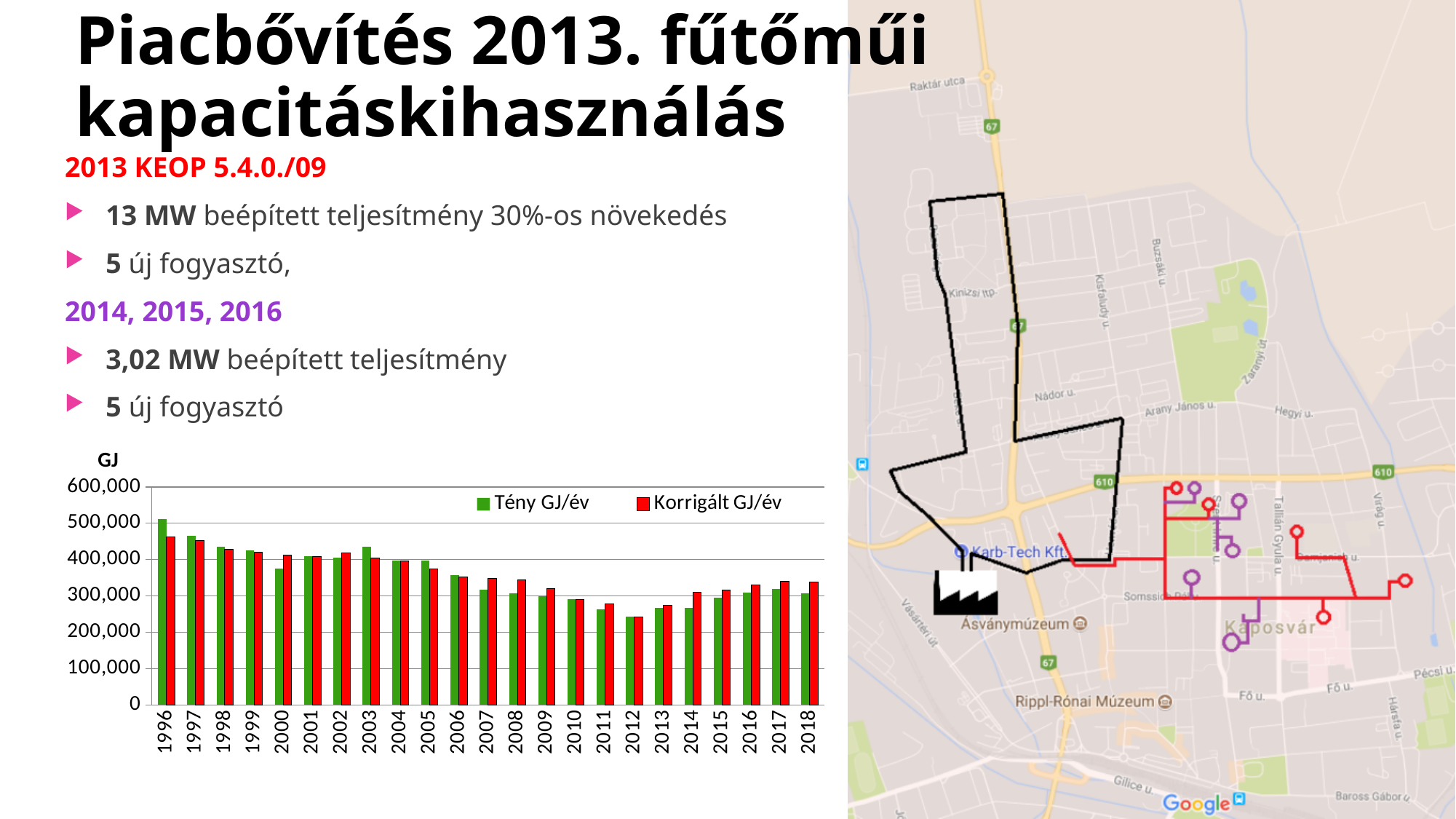
How many years are shown on the x axis of the chart? 23 In 2000, which is larger: Tény GJ/év or Korrigált GJ/év? Korrigált GJ/év Do the Tény GJ/év values generally rise or fall from 1996 to 2012? fall Which year has the lowest Korrigált GJ/év value? 2012 What colour are the Korrigált GJ/év bars in the chart? red Is the Tény GJ/év value for 2011 greater or less than 300,000? less Is the Korrigált GJ/év value for 2012 greater or less than 300,000? less Which year has the highest Tény GJ/év value? 1996 What kind of chart is shown on the slide? bar chart How many series does the chart legend list? 2 Which year has the lowest Tény GJ/év value? 2012 Is the Tény GJ/év value for 1996 greater or less than 400,000? greater